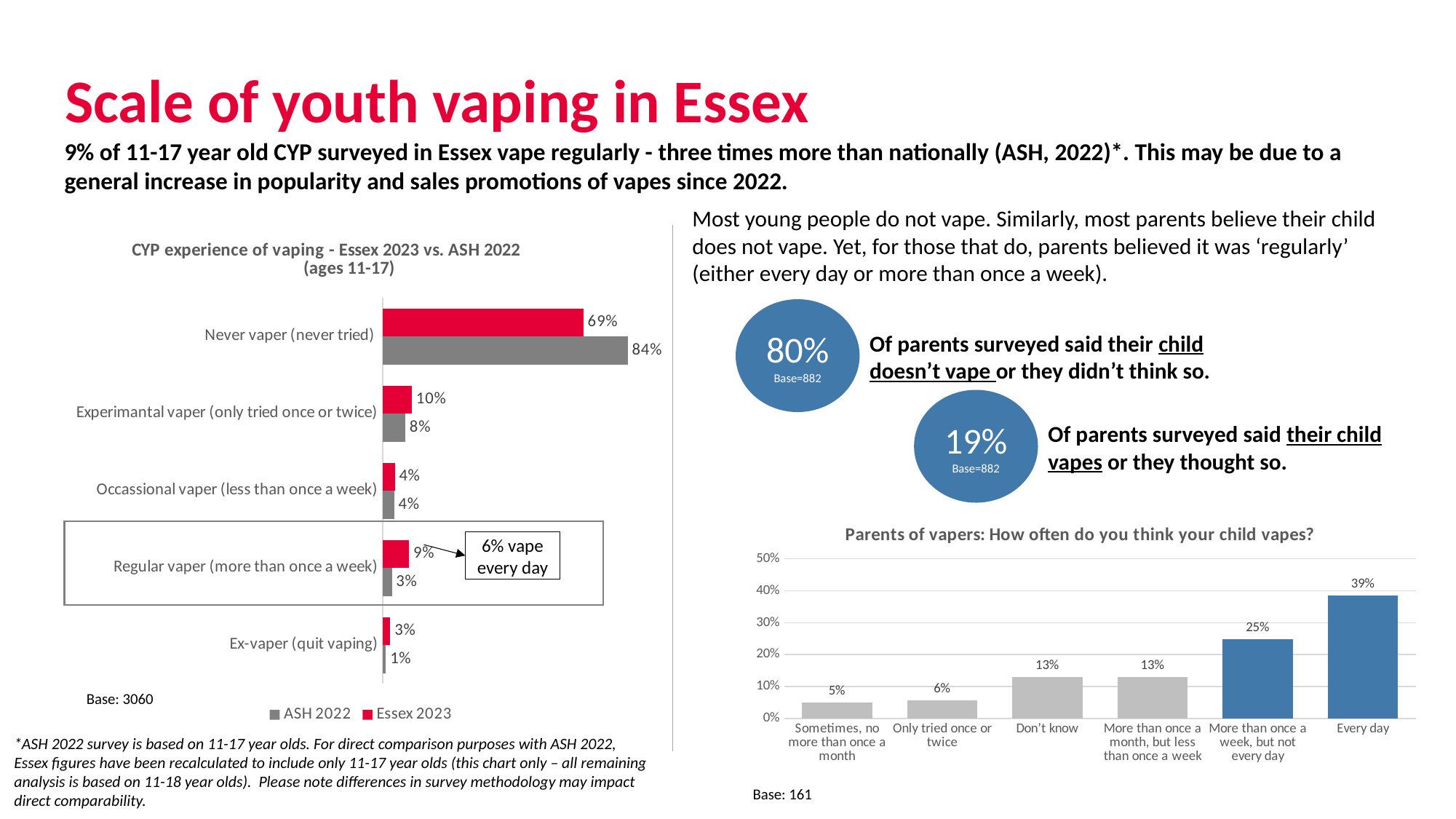
In the 'Parents of vapers: How often do you think your child vapes?' chart, what is the difference between 'Every day' and 'Don't know'? 26% In the 'CYP experience of vaping - Essex 2023 vs. ASH 2022' chart, which series has the larger value for 'Experimantal vaper (only tried once or twice)'? Essex 2023 In the 'CYP experience of vaping - Essex 2023 vs. ASH 2022' chart, what is the ASH 2022 value for 'Regular vaper (more than once a week)'? 3% In the 'Parents of vapers: How often do you think your child vapes?' chart, how many categories are shown on the x axis? 6 In the 'CYP experience of vaping - Essex 2023 vs. ASH 2022' chart, what is the Essex 2023 value for 'Never vaper (never tried)'? 69% In the 'Parents of vapers: How often do you think your child vapes?' chart, which category has the lowest value? Sometimes, no more than once a month In the 'CYP experience of vaping - Essex 2023 vs. ASH 2022' chart, what is the difference between the ASH 2022 and Essex 2023 values for 'Never vaper (never tried)'? 15% In the 'CYP experience of vaping - Essex 2023 vs. ASH 2022' chart, how many categories are shown? 5 In the 'Parents of vapers: How often do you think your child vapes?' chart, which category has the highest value? Every day In the 'Parents of vapers: How often do you think your child vapes?' chart, what is the value for 'More than once a week, but not every day'? 25% In the 'CYP experience of vaping - Essex 2023 vs. ASH 2022' chart, how many series does the legend list? 2 What type of chart is 'CYP experience of vaping - Essex 2023 vs. ASH 2022'? Bar chart